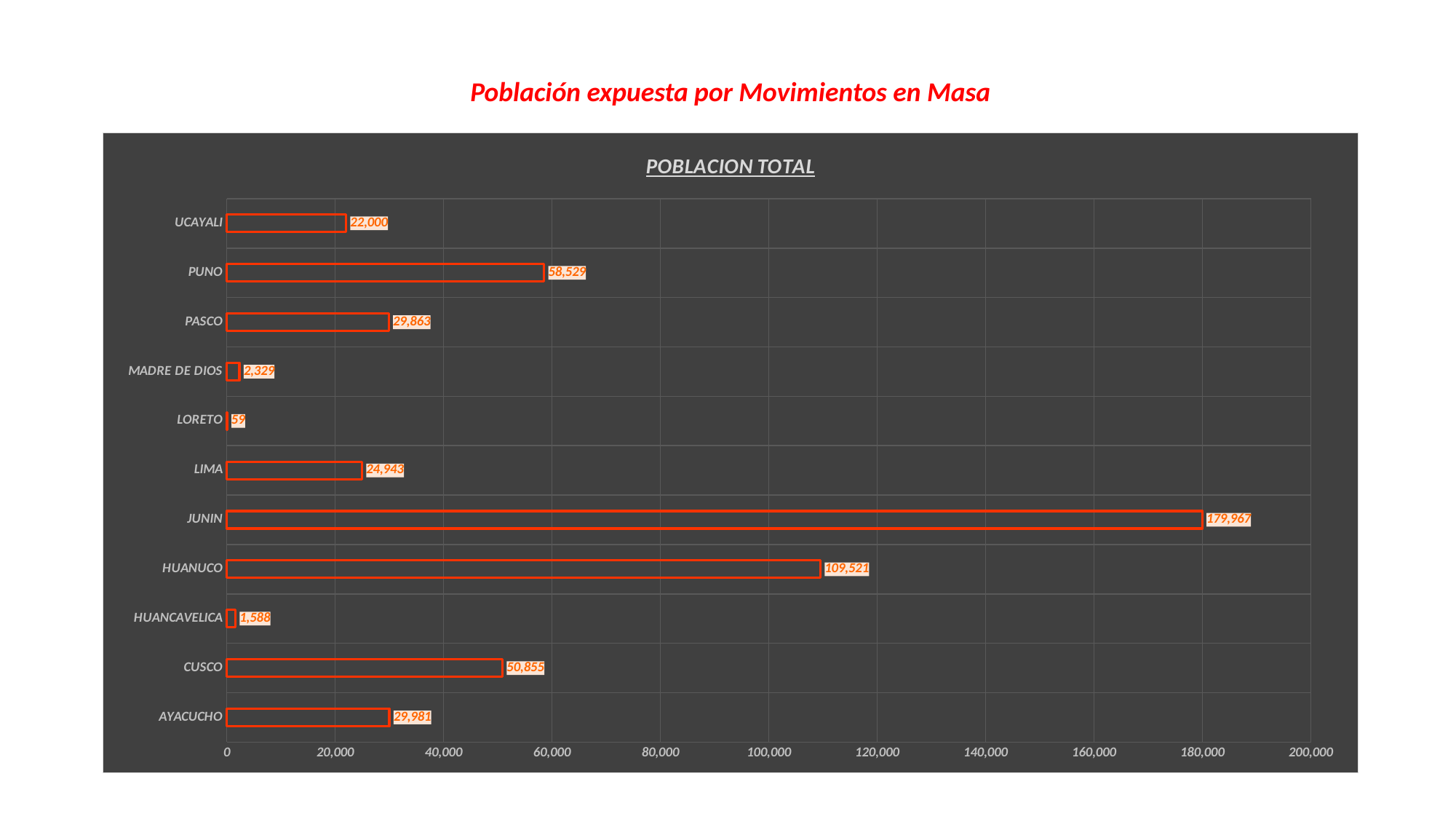
Which is larger, the value for CUSCO or the value for PUNO? PUNO Which category has the lowest value? LORETO What is the value for PUNO? 58,529 How many categories are shown in the chart? 11 What is the difference between the values for AYACUCHO and PASCO? 118 What kind of chart is shown on the slide? bar chart Is the value for HUANUCO greater or less than 100,000? greater What is the title of the chart? POBLACION TOTAL Which category has the highest value? JUNIN What is the difference between the values for JUNIN and HUANUCO? 70,446 What is the value for JUNIN? 179,967 What is the value for MADRE DE DIOS? 2,329